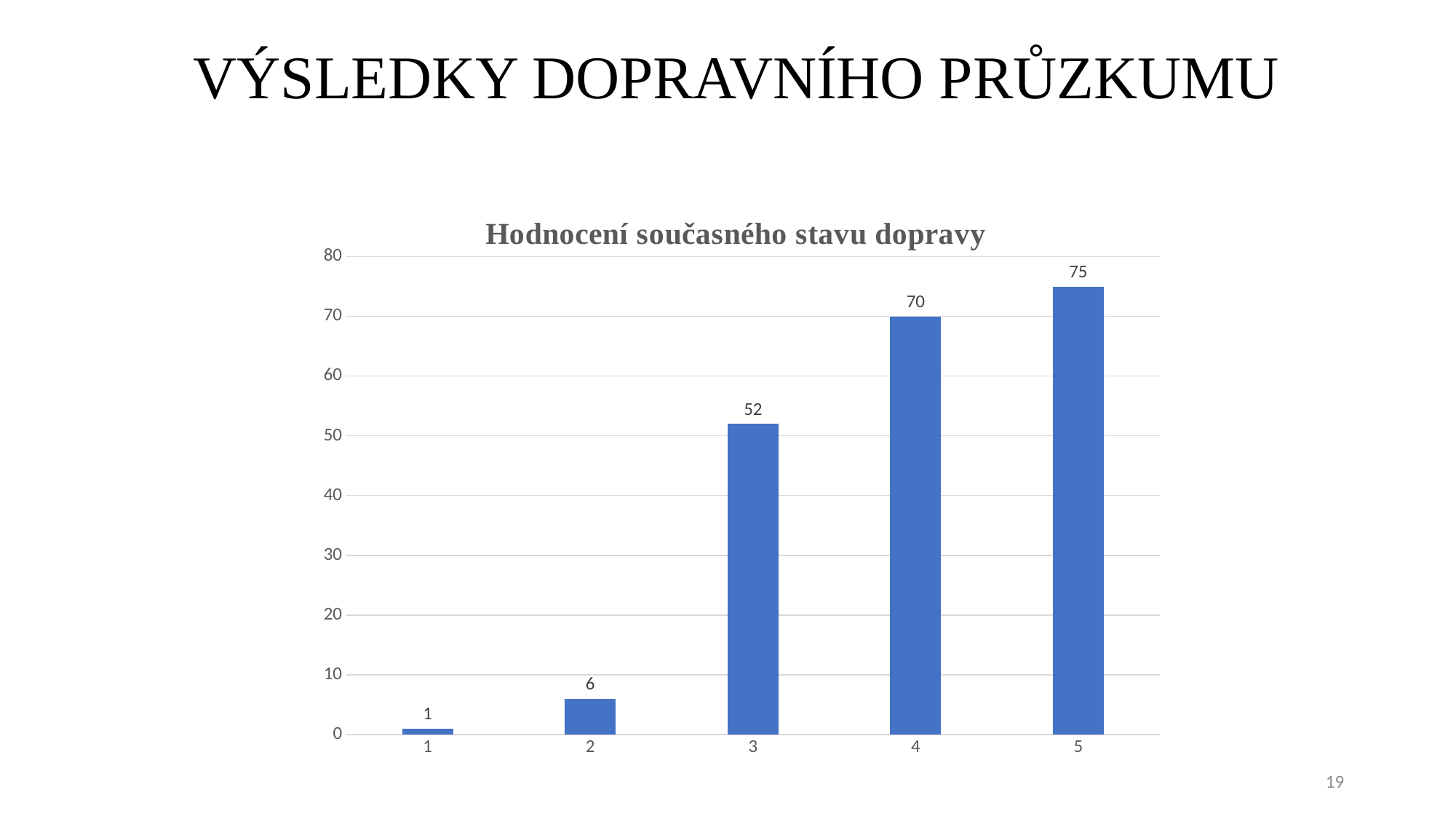
Which category has the lowest value? 1 What is the title of the chart? Hodnocení současného stavu dopravy Do the values rise or fall from category 1 to category 5? rise What is the difference between the values for category 4 and category 3? 18 Which category has the highest value? 5 Is the value for category 4 greater or less than 60? greater What is the value for category 5? 75 What kind of chart is shown? bar chart Which is larger, the value for category 2 or the value for category 4? 4 What is the value for category 1? 1 What is the value for category 3? 52 How many categories are shown on the x axis? 5